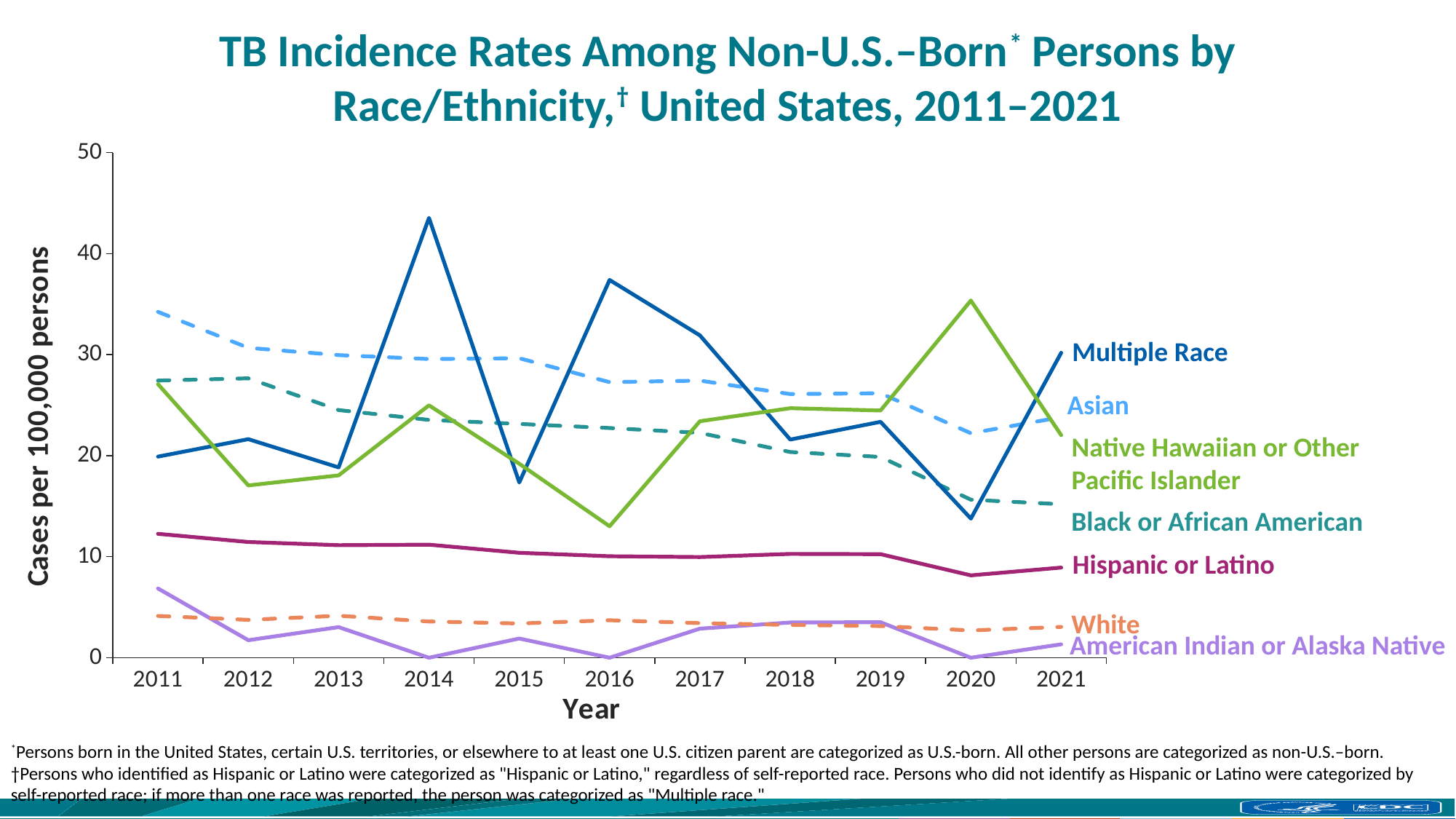
Which race/ethnicity group had the highest TB incidence rate in 2014? Multiple Race Which race/ethnicity group had the lowest TB incidence rate in 2016? American Indian or Alaska Native Which race/ethnicity group had the highest TB incidence rate in 2011? Asian Is the value for White in 2021 greater or less than 10? less How many years are shown along the x axis? 11 Is the value for Asian in 2011 greater or less than 30? greater Is the value for Multiple Race in 2014 greater or less than 40? greater What kind of chart is shown on the slide? Line chart How many race/ethnicity series are plotted on the chart? 7 Does the Asian line generally rise or fall from 2011 to 2021? Fall In 2016, which was larger: the rate for Multiple Race or for Native Hawaiian or Other Pacific Islander? Multiple Race